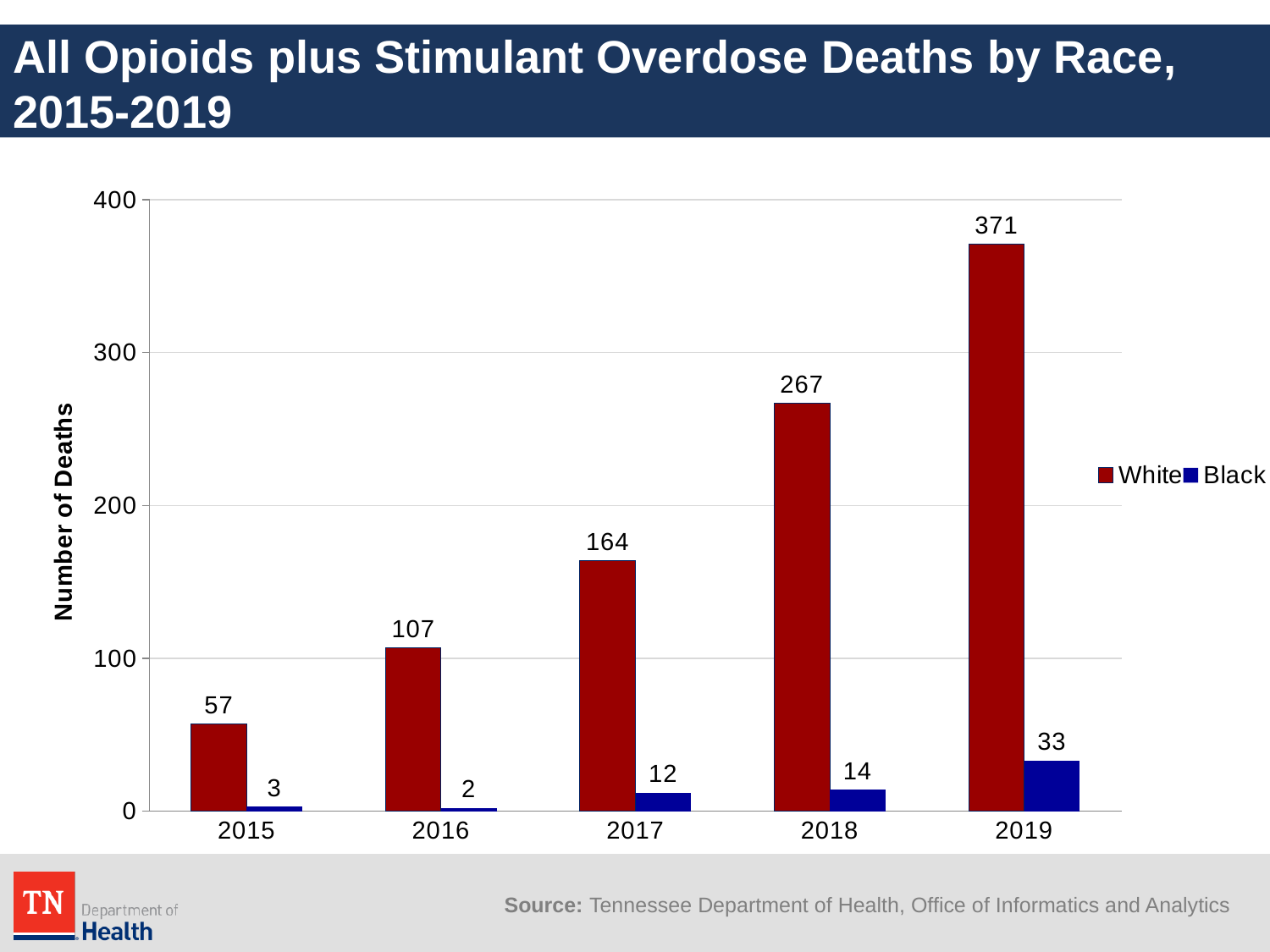
What is the number of deaths for White in 2019? 371 Which year has the lowest number of deaths for Black? 2016 How many series does the legend list? 2 How many years are shown on the x axis? 5 What kind of chart is shown on the slide? bar chart Which year has the highest number of deaths for Black? 2019 Is the value for White in 2018 greater or less than 300? less Do the White deaths rise or fall from 2015 to 2019? rise What is the number of deaths for Black in 2017? 12 What is the number of deaths for White in 2015? 57 Which is larger, White deaths in 2016 or White deaths in 2017? White deaths in 2017 What is the difference between White and Black deaths in 2018? 253